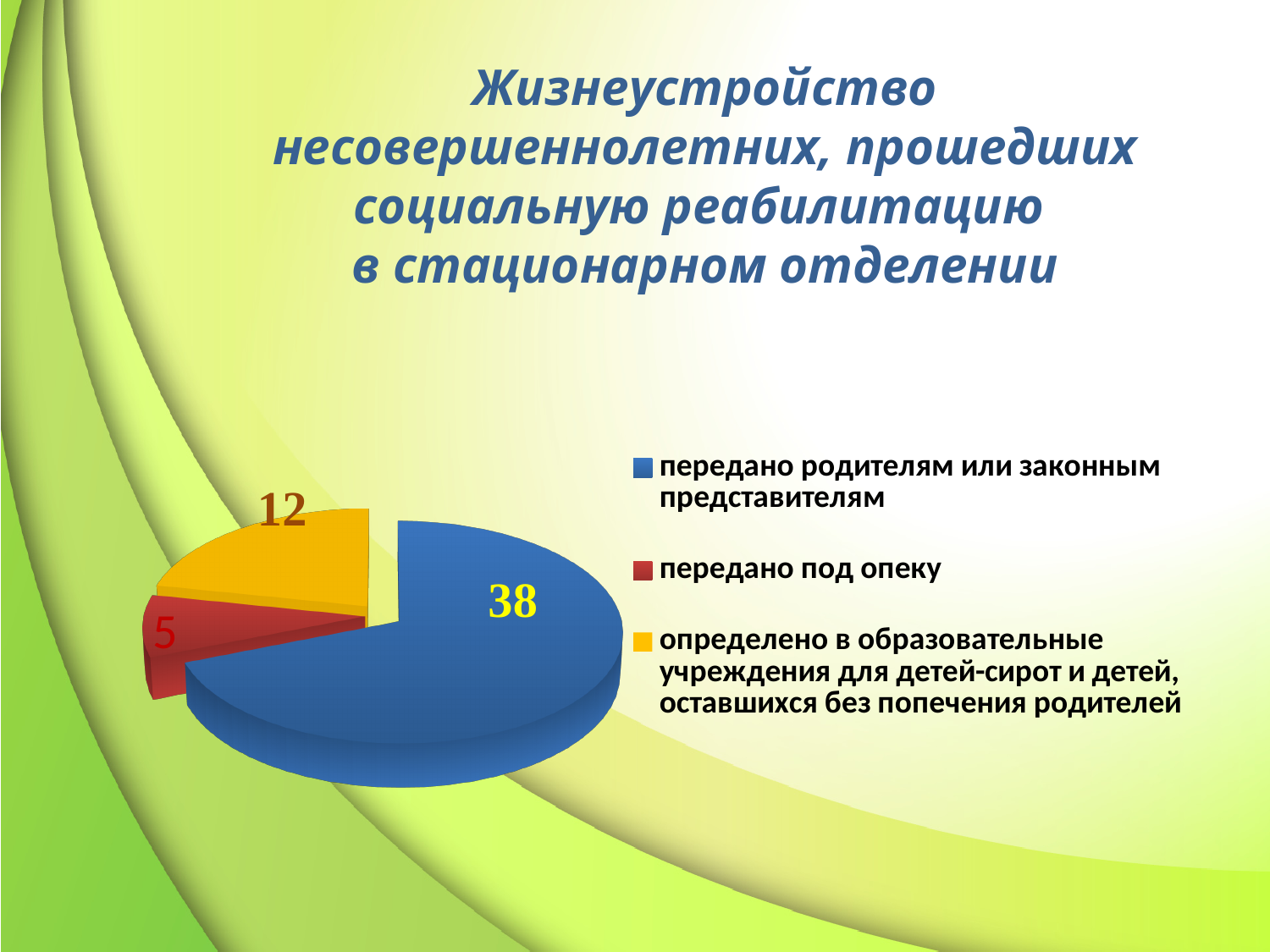
What kind of chart is shown on the slide? pie chart What is the value for 'передано под опеку'? 5 What is the total of all three slices in the pie chart? 55 What is the value for 'передано родителям или законным представителям'? 38 Which is larger: the value for 'передано под опеку' or the value for 'определено в образовательные учреждения'? определено в образовательные учреждения What colour is the slice for 'передано под опеку'? red What is the value for 'определено в образовательные учреждения для детей-сирот и детей, оставшихся без попечения родителей'? 12 Which category has the smallest slice of the pie? передано под опеку What is the difference between the value for 'передано родителям или законным представителям' and the value for 'определено в образовательные учреждения'? 26 How many entries does the legend of the pie chart list? 3 Which category has the largest slice of the pie? передано родителям или законным представителям How many slices does the pie chart have? 3